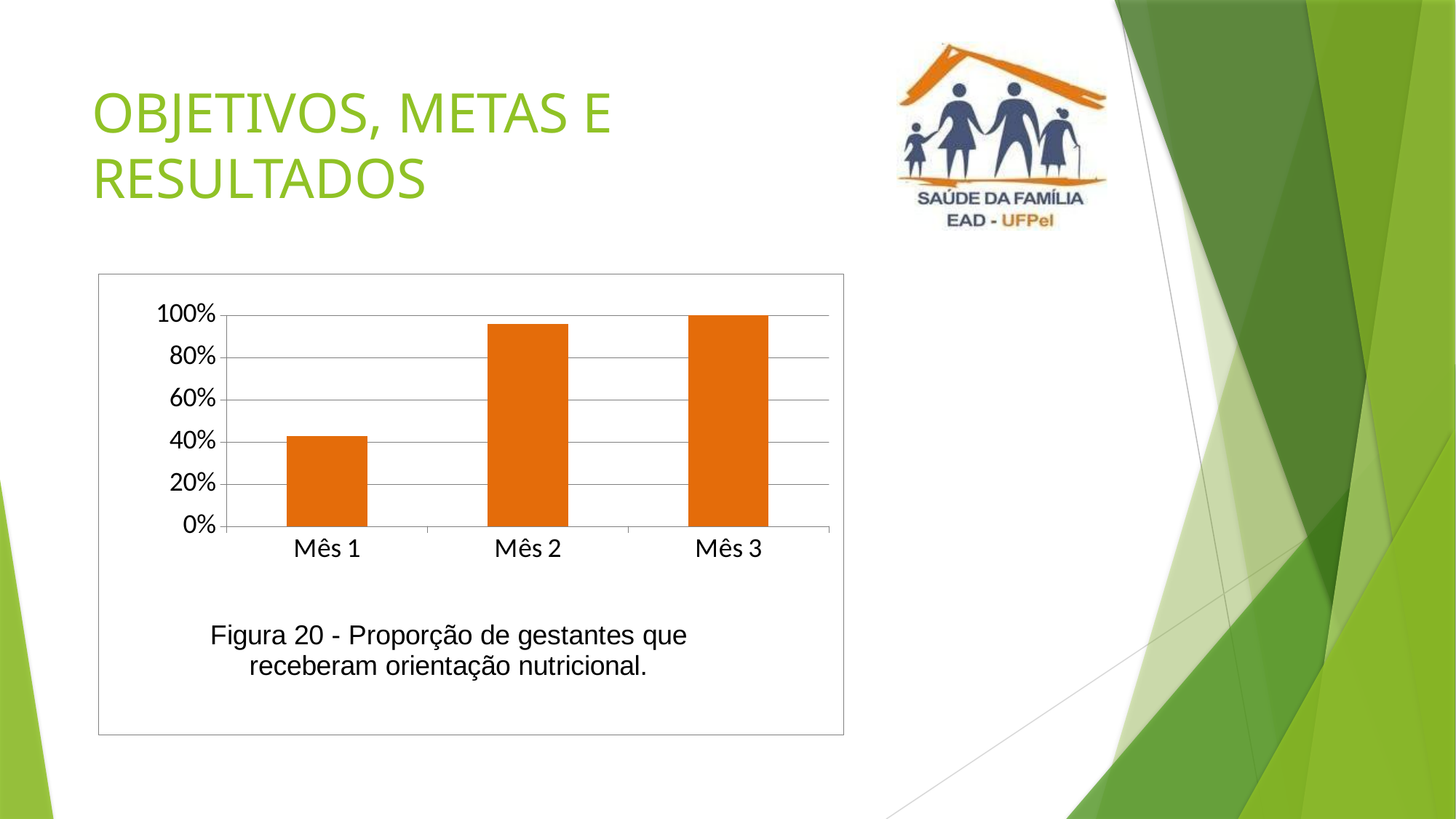
What is the caption (figure title) given for the chart? Figura 20 - Proporção de gestantes que receberam orientação nutricional. What kind of chart is shown on the slide? Bar chart Which is larger, the value for Mês 1 or the value for Mês 2? Mês 2 Do the values rise or fall from Mês 1 to Mês 3? Rise Is the value for Mês 1 greater or less than 60%? less Is the value for Mês 2 greater or less than 80%? greater How many categories (months) are plotted on the chart? 3 Which month has the highest proportion of pregnant women who received nutritional guidance? Mês 3 What is the value for Mês 3? 100% What colour are the bars in the chart? Orange Which month has the lowest value on the chart? Mês 1 Is the value for Mês 1 greater or less than 20%? greater